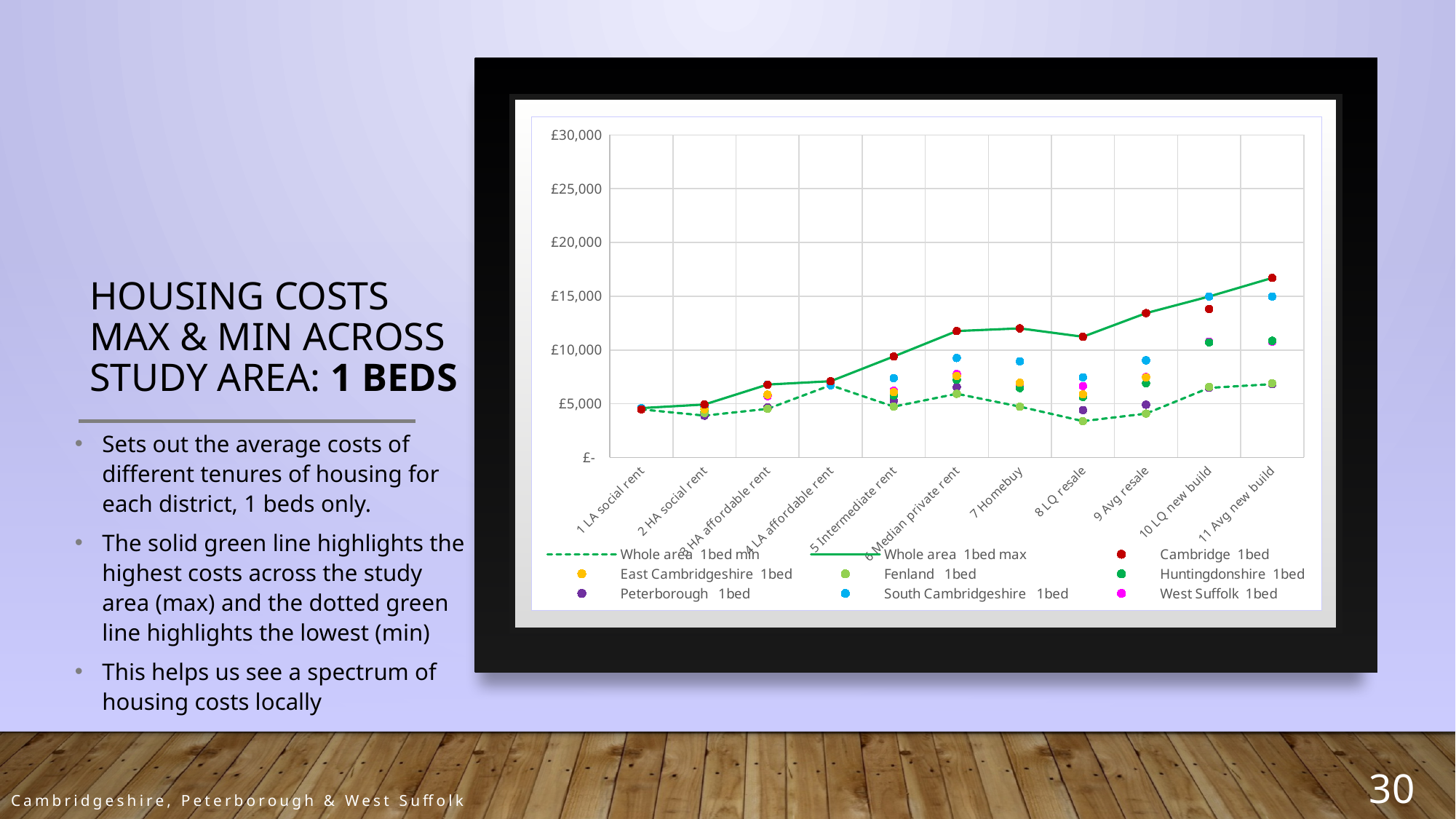
What type of chart is shown on the slide? line chart At which category does the Whole area 1bed min line reach its lowest value? 8 LQ resale Is the value of the Whole area 1bed max line at 11 Avg new build greater or less than £15,000? greater Is the Cambridge 1bed value at 7 Homebuy greater or less than £10,000? greater At 11 Avg new build, which is larger: the Cambridge 1bed value or the Fenland 1bed value? Cambridge 1bed How many categories are shown along the x axis of the chart? 11 At which category does the Whole area 1bed max line reach its highest value? 11 Avg new build Does the Whole area 1bed max line generally rise or fall from 1 LA social rent to 11 Avg new build? rise Is the value of the Whole area 1bed min line at 8 LQ resale greater or less than £5,000? less How many series does the chart legend list? 9 Which series does the solid green line represent? Whole area 1bed max